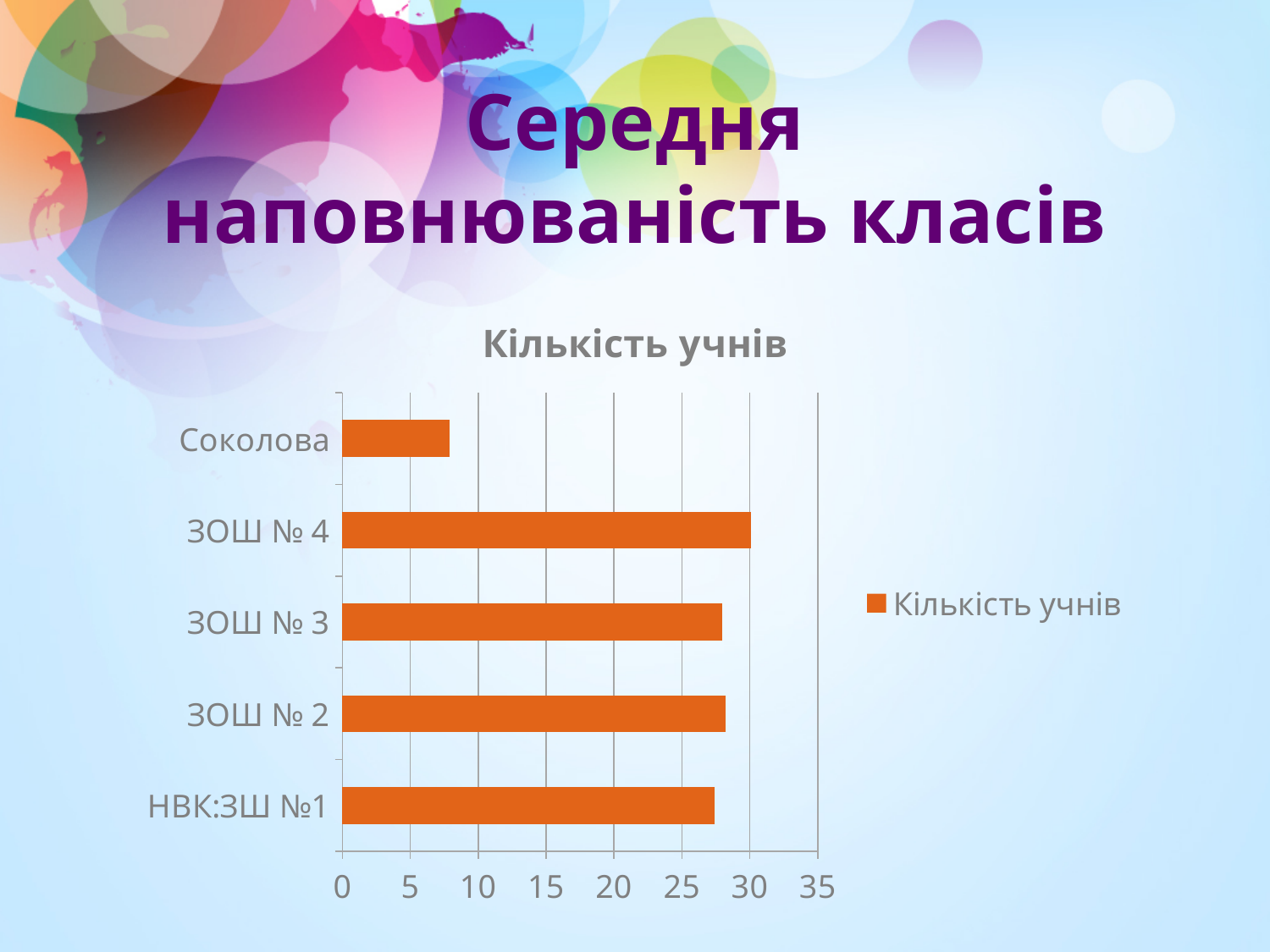
Is the value for Соколова greater or less than 10? less Which category has the highest value? ЗОШ № 4 What is the title of the chart? Кількість учнів Is the value for ЗОШ № 4 greater or less than 35? less How many categories are shown on the chart? 5 Is the value for НВК:ЗШ №1 greater or less than 25? greater What is the legend entry shown on the chart? Кількість учнів What kind of chart is shown on the slide? bar chart Which is larger, the value for Соколова or the value for ЗОШ № 2? ЗОШ № 2 How many series does the legend list? 1 Which category has the lowest value? Соколова